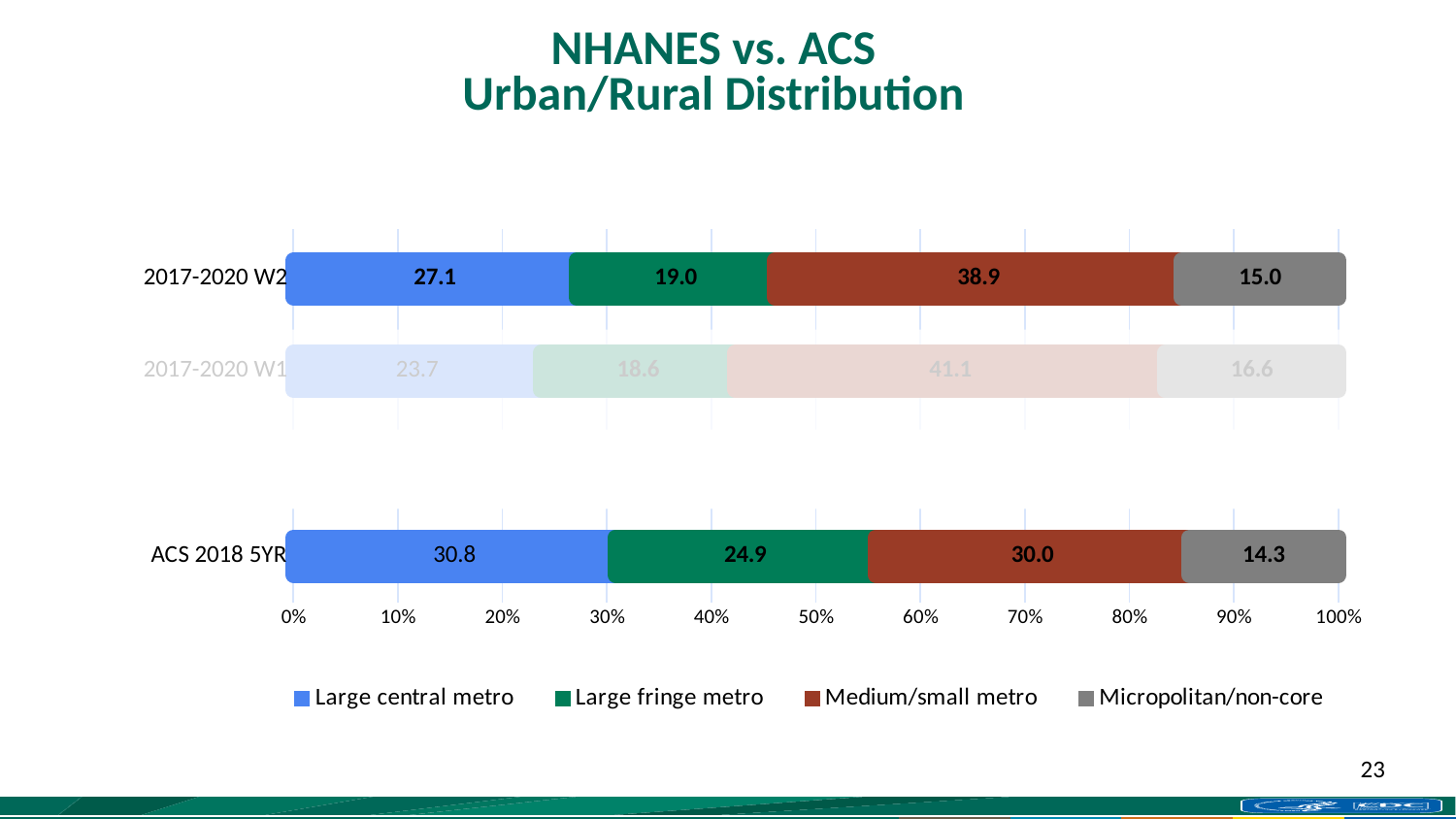
What is the title of the chart on the slide? NHANES vs. ACS Urban/Rural Distribution Which category has the lowest Large central metro value? 2017-2020 W1 What kind of chart is shown on the slide? Stacked bar chart What is the Micropolitan/non-core value for 2017-2020 W1? 16.6 Which category has the highest Medium/small metro value? 2017-2020 W1 Which is larger: the Large fringe metro value for 2017-2020 W2 or for ACS 2018 5YR? ACS 2018 5YR How many series does the legend list? 4 What is the Large fringe metro value for ACS 2018 5YR? 24.9 What is the Medium/small metro value for ACS 2018 5YR? 30.0 What is the difference between the Medium/small metro values for 2017-2020 W2 and ACS 2018 5YR? 8.9 How many bars (categories) are plotted on the chart? 3 What is the Large central metro value for 2017-2020 W2? 27.1